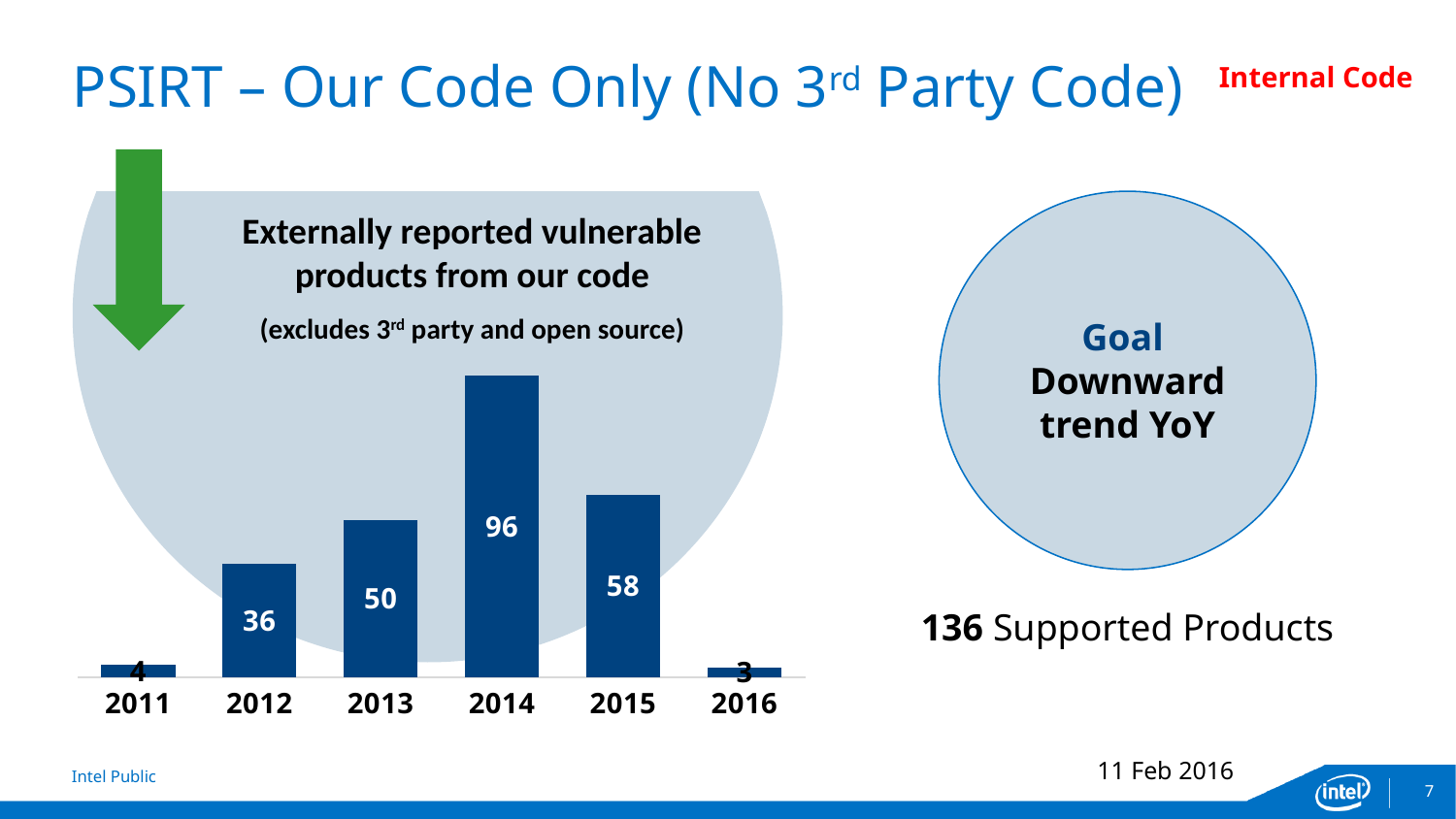
Which is larger, the value for 2013 or the value for 2015? 2015 Do the values rise or fall from 2014 to 2016? Fall How many years are shown on the x axis? 6 What is the value for 2015? 58 What is the value for 2014? 96 Which year has the highest value? 2014 What is the value for 2011? 4 What is the difference between the values for 2013 and 2012? 14 What is the difference between the values for 2014 and 2015? 38 What kind of chart is shown? Bar chart What is the value for 2012? 36 Which year has the lowest value? 2016